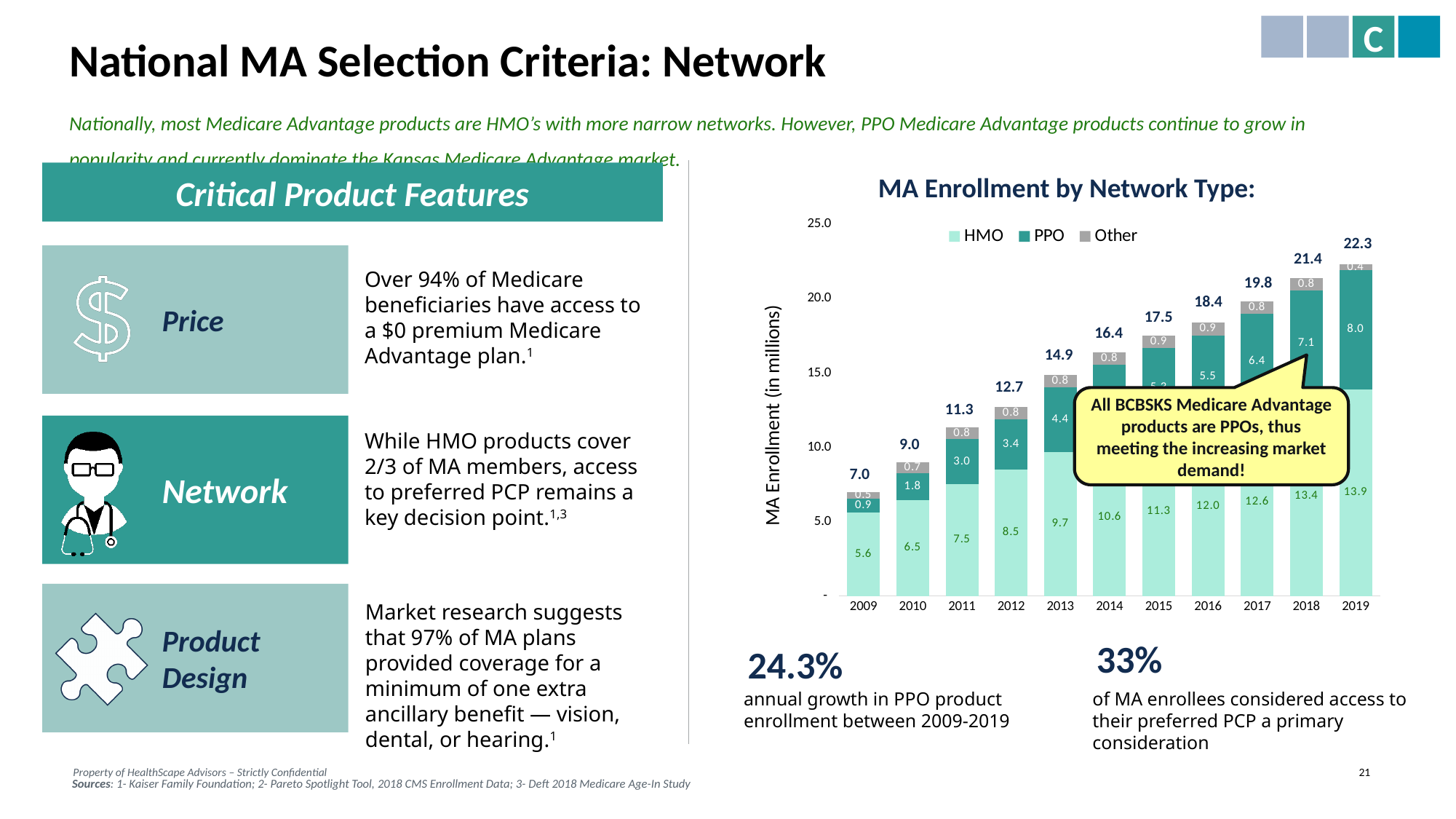
In the 'MA Enrollment by Network Type' chart, what is the PPO value for 2019? 8.0 How many years are shown on the x axis of the 'MA Enrollment by Network Type' chart? 11 What type of chart is 'MA Enrollment by Network Type'? stacked bar chart In the 'MA Enrollment by Network Type' chart, is the HMO value for 2011 larger than the PPO value for 2011? Yes In the 'MA Enrollment by Network Type' chart, what is the difference between the PPO values for 2018 and 2009? 6.2 In the 'MA Enrollment by Network Type' chart, is the total enrollment for 2013 greater or less than 15.0? less In the 'MA Enrollment by Network Type' chart, what is the total enrollment shown for 2015? 17.5 In the 'MA Enrollment by Network Type' chart, do total enrollment values rise or fall from 2009 to 2019? rise In the 'MA Enrollment by Network Type' chart, which year has the highest total enrollment? 2019 How many series does the legend of the 'MA Enrollment by Network Type' chart list? 3 In the 'MA Enrollment by Network Type' chart, which year has the lowest HMO value? 2009 In the 'MA Enrollment by Network Type' chart, what is the HMO value for 2012? 8.5